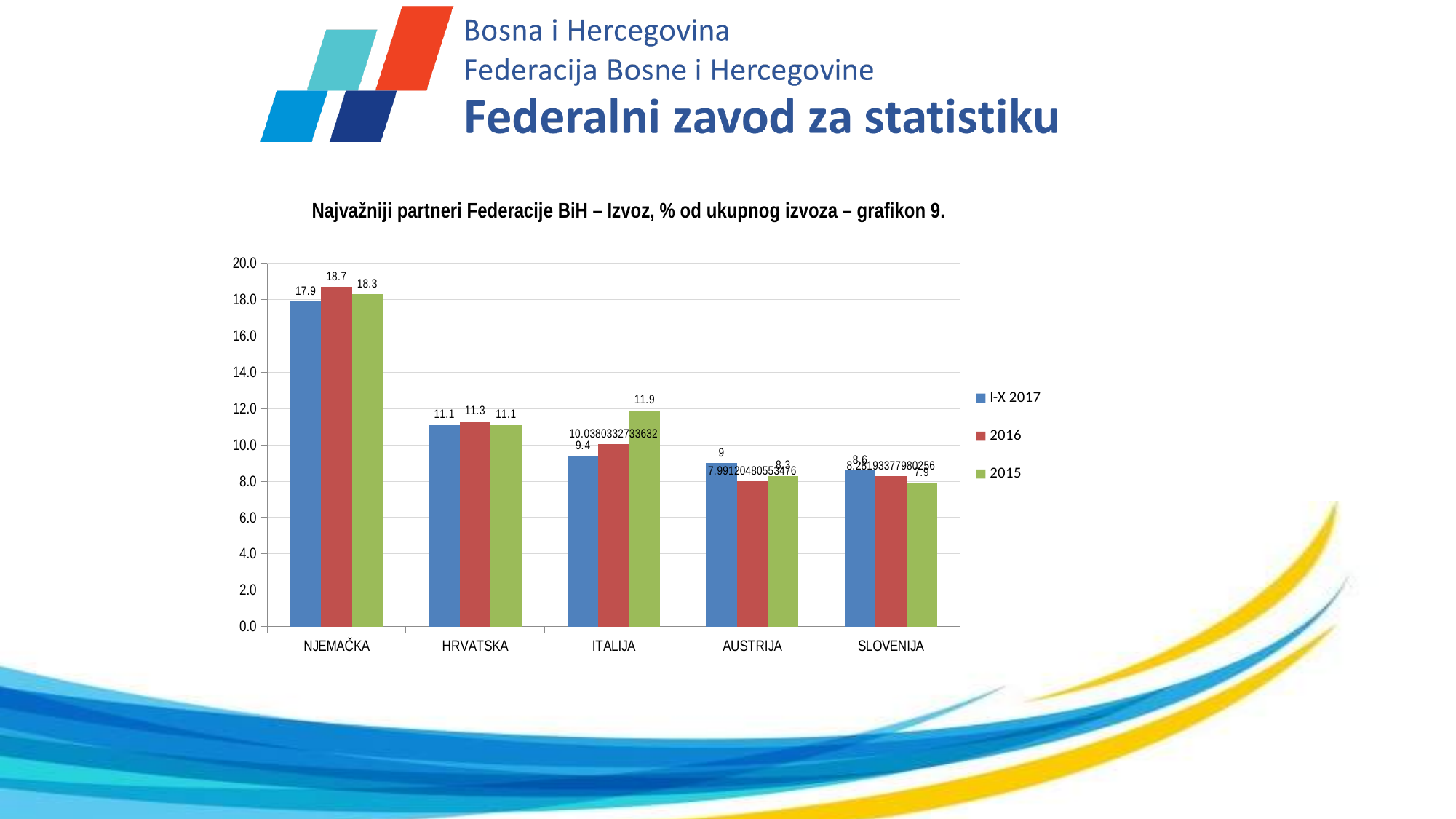
What is the difference between the 2016 and I-X 2017 values for NJEMAČKA? 0.8 How many series does the legend list? 3 What is the value for NJEMAČKA in I-X 2017? 17.9 Which country has the highest value in the 2015 series? NJEMAČKA Which is larger for ITALIJA: the I-X 2017 value or the 2015 value? 2015 Which country has the lowest value in the 2015 series? SLOVENIJA How many countries are shown on the x axis? 5 Is the 2016 value for AUSTRIJA greater or less than 10.0? less What is the value for NJEMAČKA in 2016? 18.7 What is the value for ITALIJA in 2015? 11.9 What is the value for HRVATSKA in 2016? 11.3 What type of chart is shown on the slide? bar chart